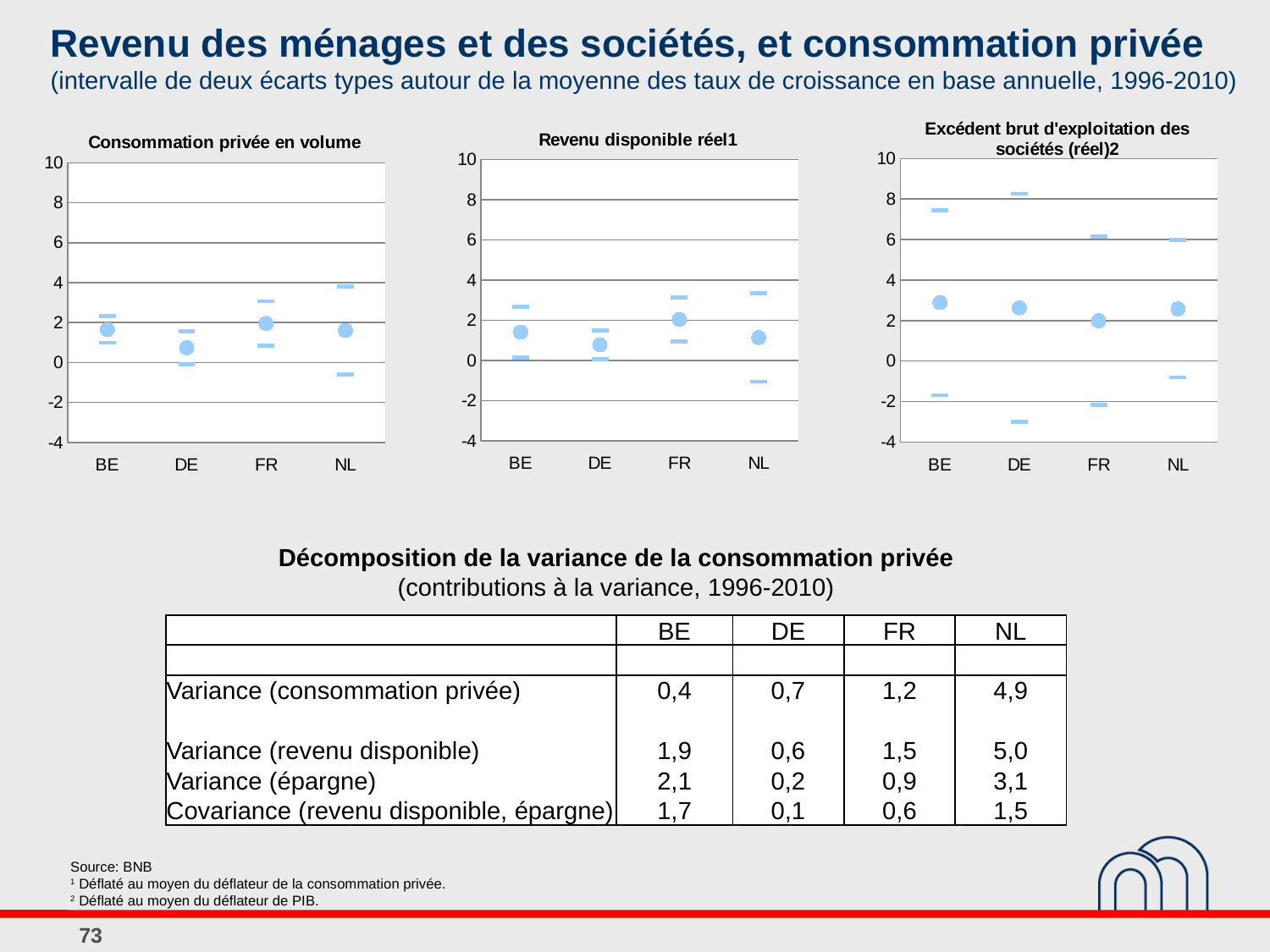
In the chart 'Consommation privée en volume', which country has the lowest mean (dot) value? DE In the chart 'Revenu disponible réel', which country has the highest mean (dot) value? FR In the chart 'Revenu disponible réel', which country has the lowest lower band marker? NL How many charts are shown on the slide? 3 In the chart 'Revenu disponible réel', is the mean (dot) value for FR larger or smaller than that for DE? larger In the chart 'Consommation privée en volume', is the mean (dot) value for DE greater or less than 2? less In the chart 'Excédent brut d'exploitation des sociétés (réel)', is the mean (dot) value for BE greater or less than 2? greater In the chart 'Consommation privée en volume', how many countries are plotted on the x axis? 4 In the chart 'Excédent brut d'exploitation des sociétés (réel)', which country has the lowest mean (dot) value? FR In the chart 'Consommation privée en volume', which country has the highest upper band marker? NL What is the title of the middle chart? Revenu disponible réel In the chart 'Excédent brut d'exploitation des sociétés (réel)', is the lower band marker for DE greater or less than -2? less